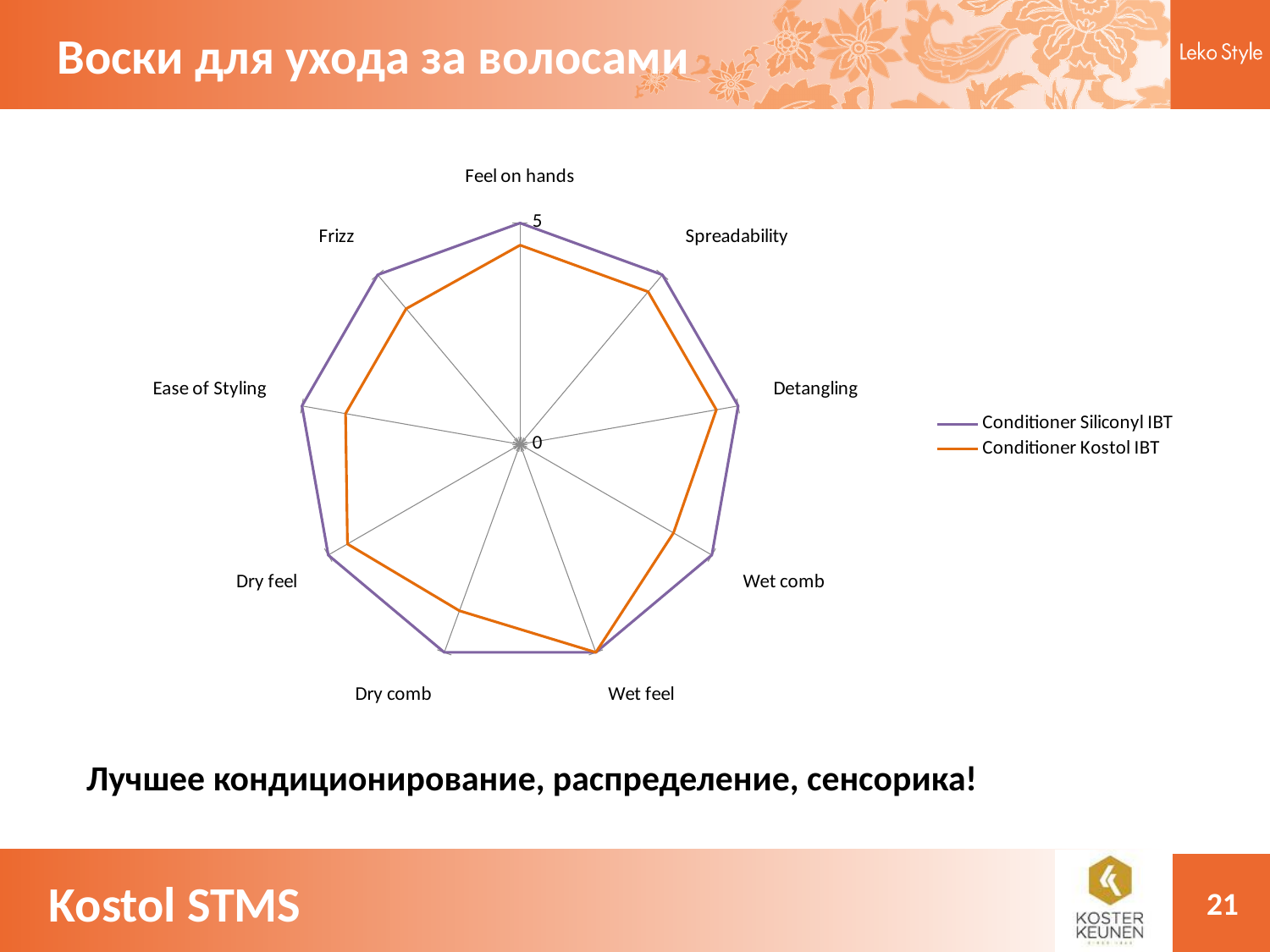
Which category is labelled at the top of the radar chart? Feel on hands What is the value for Conditioner Siliconyl IBT on the Feel on hands axis? 5 Which series has the larger value for Dry comb, Conditioner Siliconyl IBT or Conditioner Kostol IBT? Conditioner Siliconyl IBT Which series is drawn in orange on the radar chart? Conditioner Kostol IBT Which series has the larger value for Feel on hands, Conditioner Siliconyl IBT or Conditioner Kostol IBT? Conditioner Siliconyl IBT What is the maximum value shown on the radar chart's axis scale? 5 Which series has the larger value for Frizz, Conditioner Siliconyl IBT or Conditioner Kostol IBT? Conditioner Siliconyl IBT How many series does the legend of the radar chart list? 2 How many categories (axes) does the radar chart have? 9 What kind of chart is shown on the slide? Radar chart